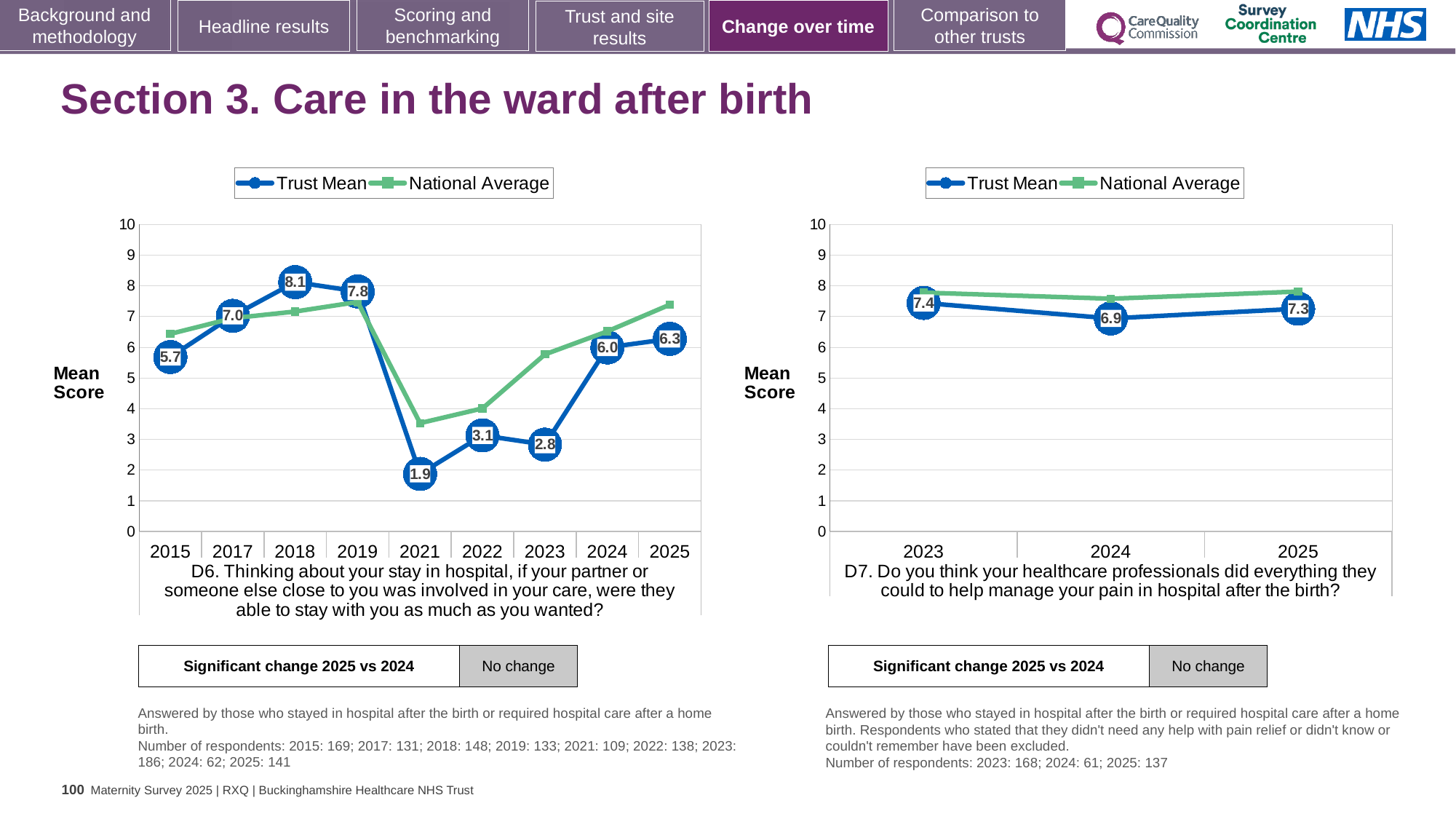
What kind of chart is the right chart (D7)? Line chart In the left chart (D6), which year has the highest Trust Mean score? 2018 In the left chart (D6), which year has the lowest Trust Mean score? 2021 In the right chart (D7), what is the Trust Mean score for 2024? 6.9 In the left chart (D6), what is the Trust Mean score for 2018? 8.1 In the right chart (D7), which year has the highest Trust Mean score? 2023 In the left chart (D6), what is the difference between the Trust Mean scores for 2025 and 2024? 0.3 In the right chart (D7), how many series does the legend list? 2 In the left chart (D6), is the National Average value for 2021 greater or less than 4? less In the left chart (D6), how many years are shown on the x axis? 9 In the left chart (D6), is the Trust Mean score for 2022 or 2023 larger? 2022 In the left chart (D6), what is the Trust Mean score for 2021? 1.9